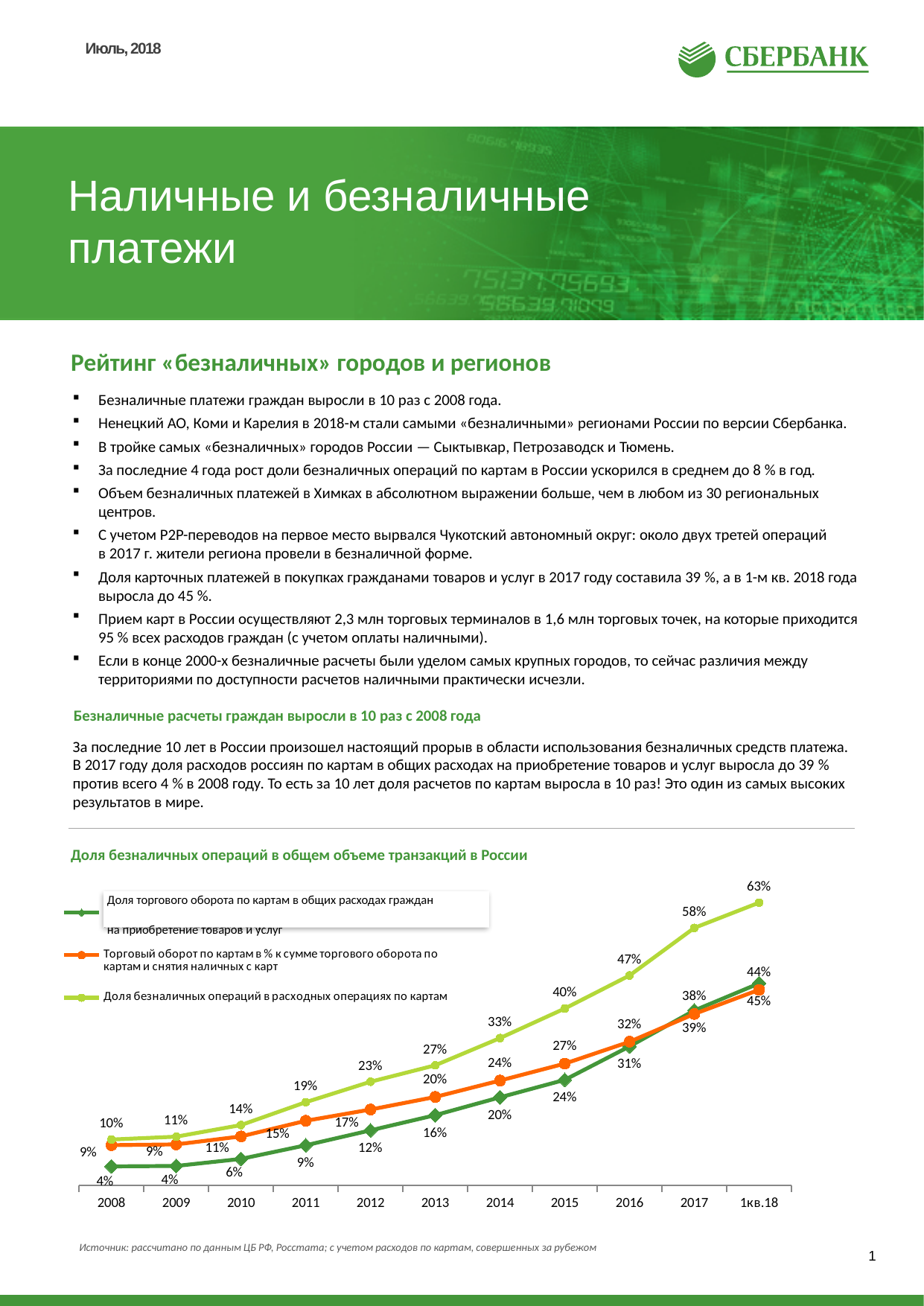
In which period does «Доля безналичных операций в расходных операциях по картам» reach its highest value? 1кв.18 What kind of chart is shown under the title «Доля безналичных операций в общем объеме транзакций в России»? Line chart How many periods are shown along the x axis of the chart? 11 What is the value of «Торговый оборот по картам в % к сумме торгового оборота по картам и снятия наличных с карт» for 2013? 20% In 2015, which is larger: «Доля безналичных операций в расходных операциях по картам» or «Торговый оборот по картам в % к сумме торгового оборота по картам и снятия наличных с карт»? Доля безналичных операций в расходных операциях по картам Do the values of the series in the chart rise or fall from 2008 to 1кв.18? Rise What is the value of «Доля безналичных операций в расходных операциях по картам» for 2014? 33% What is the value of «Доля безналичных операций в расходных операциях по картам» for 2017? 58% How many series does the legend of the chart list? 3 What is the value of «Доля безналичных операций в расходных операциях по картам» for 1кв.18? 63% What is the value of «Доля торгового оборота по картам в общих расходах граждан на приобретение товаров и услуг» for 2008? 4% By how many percentage points did «Доля безналичных операций в расходных операциях по картам» increase from 2008 to 1кв.18? 53 percentage points